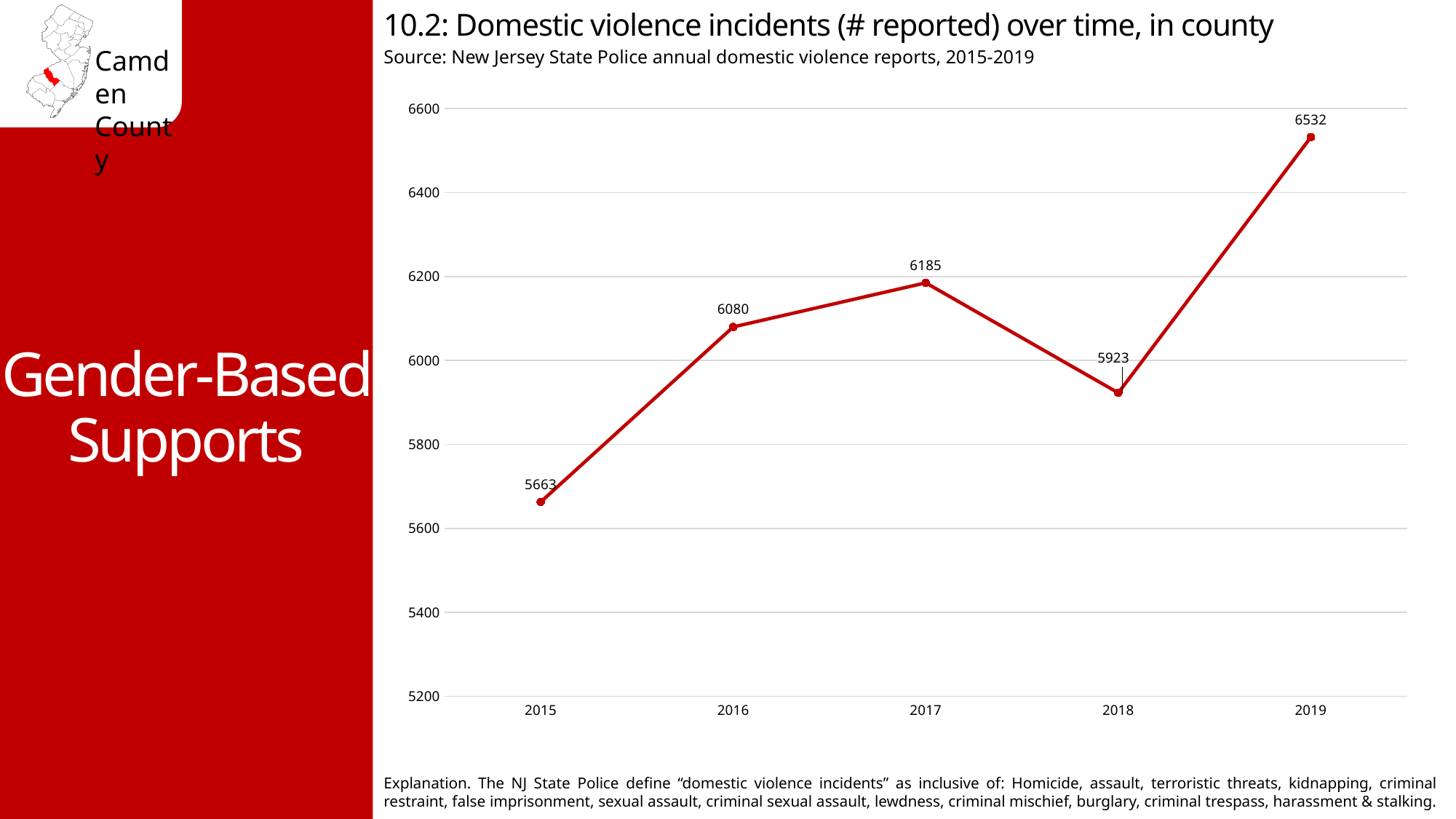
What was the number of reported domestic violence incidents in 2018? 5923 Is the value for 2017 greater or less than 6000? greater Did the number of reported incidents rise or fall from 2017 to 2018? fall Which year had the lowest number of reported domestic violence incidents? 2015 What is the difference between the number of incidents in 2019 and 2018? 609 Which year had more reported incidents, 2016 or 2018? 2016 How many years are plotted on the chart? 5 Which year had the highest number of reported domestic violence incidents? 2019 What was the number of reported domestic violence incidents in 2015? 5663 What is the difference between the number of incidents in 2016 and 2015? 417 What kind of chart is shown on the slide? line chart What was the number of reported domestic violence incidents in 2017? 6185